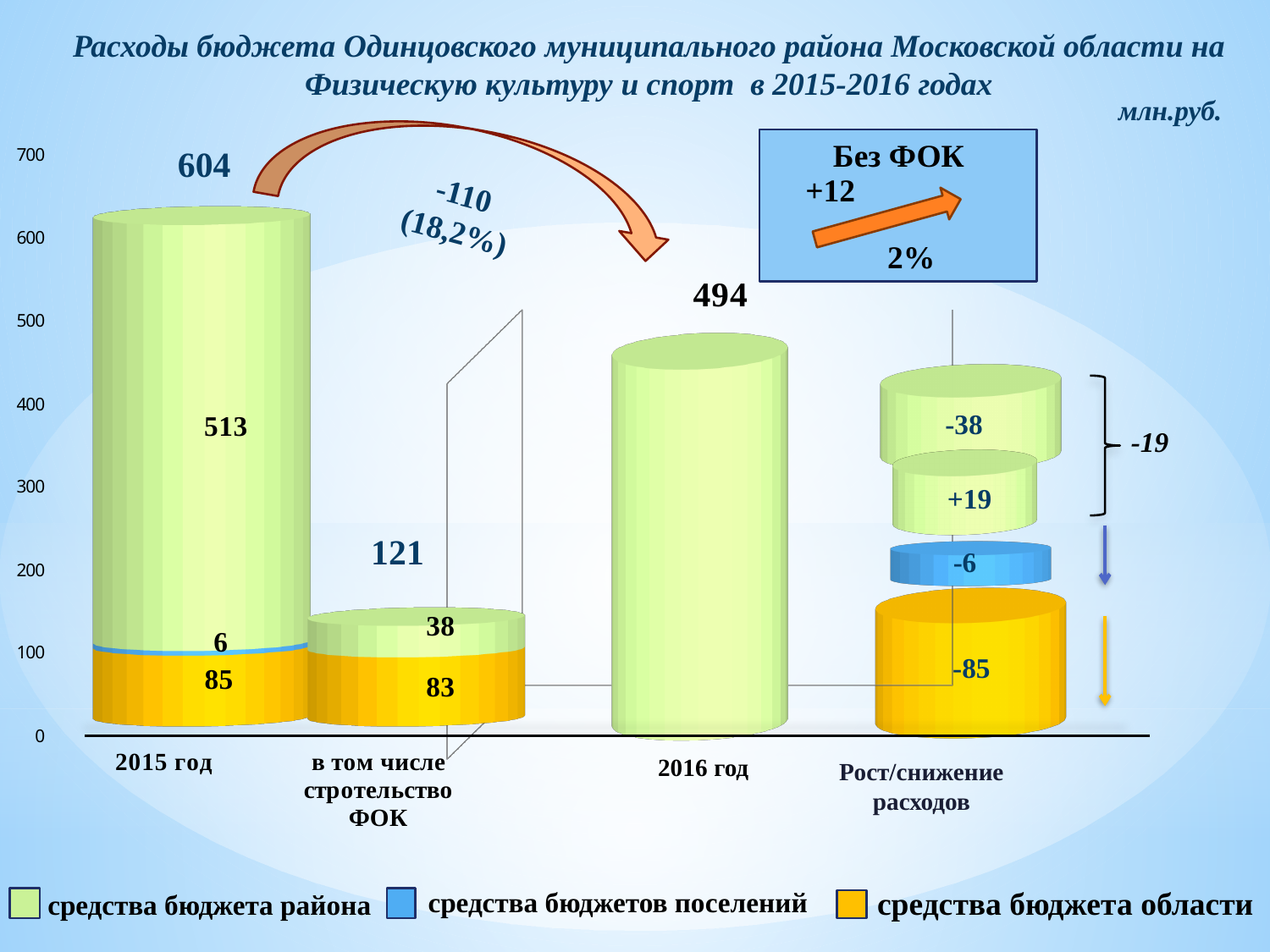
What is the total value shown above the bar for 2015 год? 604 What is the total value shown above the bar for в том числе строительство ФОК? 121 What is the value of средства бюджета области in the 2015 год bar? 85 Which is larger, the total for 2015 год or the total for 2016 год? 2015 год What is the total value shown above the bar for 2016 год? 494 What unit of measurement is indicated for the chart values? млн.руб. What is the value of средства бюджета района in the 2015 год bar? 513 How many series does the legend list? 3 What is the value of средства бюджетов поселений in the 2015 год bar? 6 What kind of chart is shown on the slide? bar chart What is the value of средства бюджета области in the в том числе строительство ФОК bar? 83 What is the difference between the totals for 2015 год and 2016 год? 110